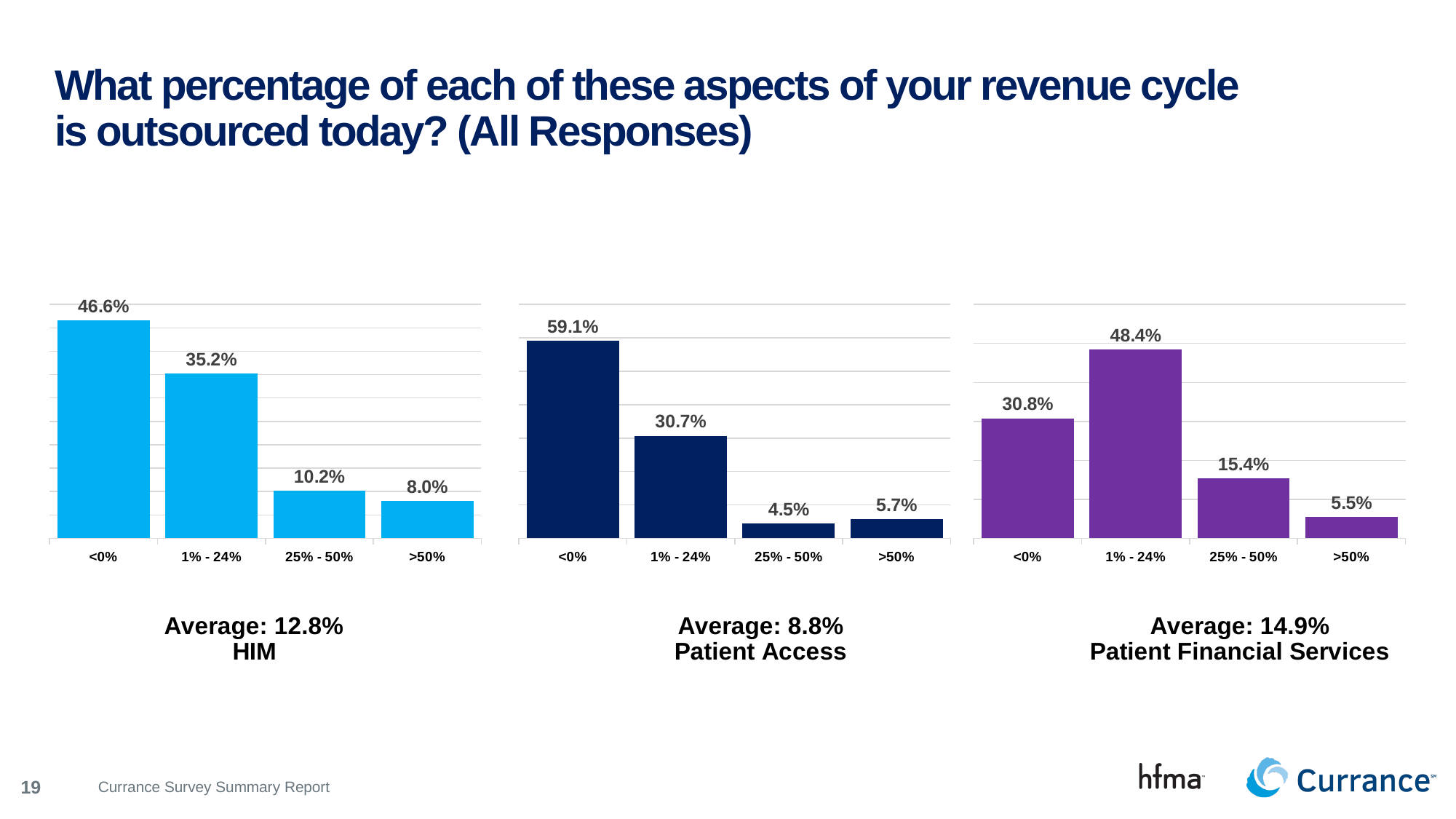
In the Patient Access chart, which category has the lowest value? 25% - 50% In the Patient Access chart, which is larger: the value for <0% or the value for 1% - 24%? <0% What average is shown below the Patient Financial Services chart? 14.9% How many categories are shown in the Patient Financial Services chart? 4 In the Patient Access chart, what is the value for the 1% - 24% category? 30.7% In the HIM chart, what is the difference between the <0% and 1% - 24% values? 11.4% What kind of chart is the HIM chart? Bar chart What colour are the bars in the Patient Financial Services chart? Purple In the Patient Financial Services chart, which category has the highest value? 1% - 24% In the Patient Financial Services chart, what is the value for the 25% - 50% category? 15.4% In the HIM chart, what is the value for the <0% category? 46.6% In the Patient Access chart, do the values generally rise or fall from <0% to 25% - 50%? Fall